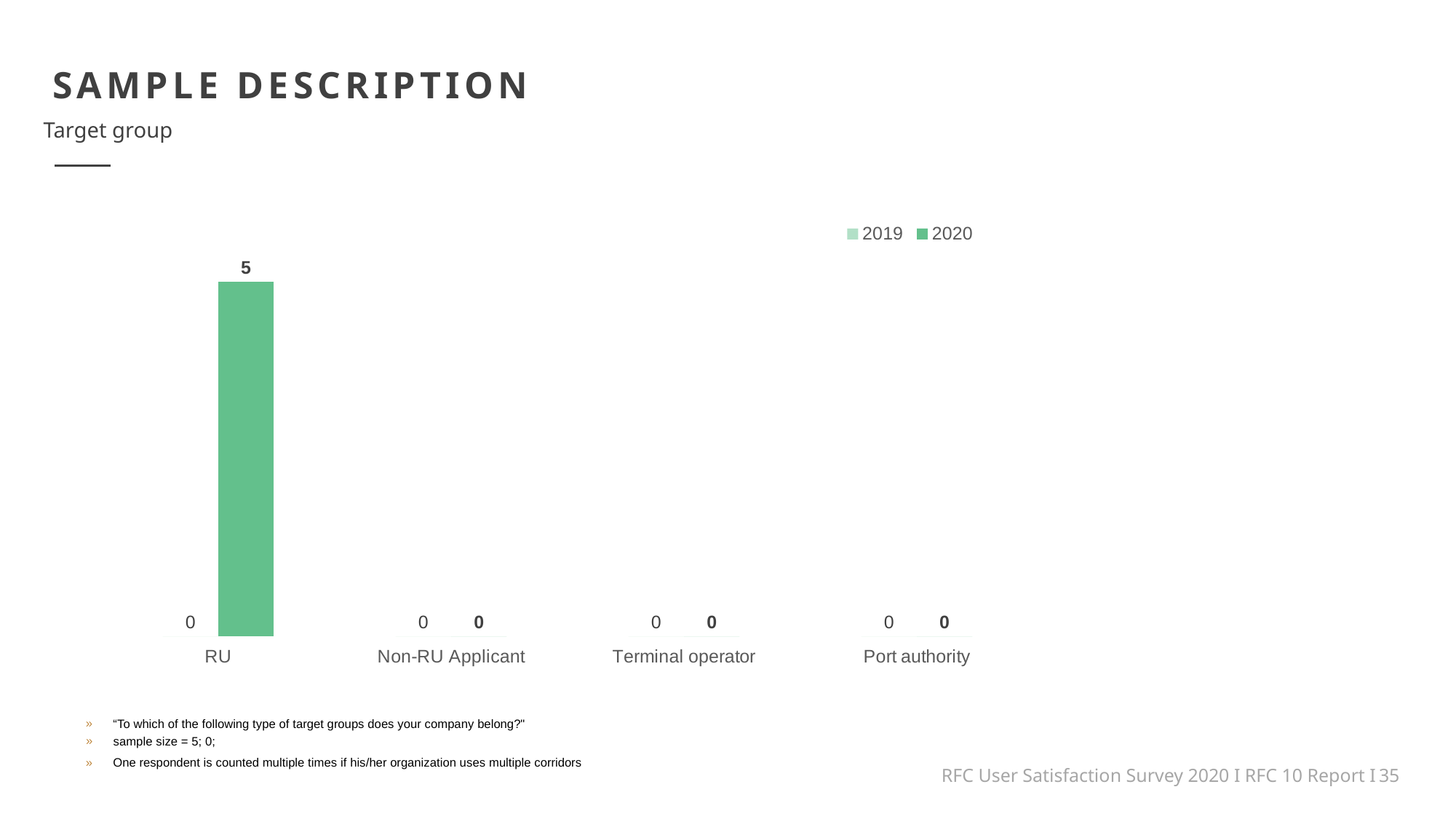
What is the 2020 value for Terminal operator? 0 What kind of chart is shown on the slide? bar chart What is the 2019 value for RU? 0 Which is larger for RU, the 2019 value or the 2020 value? 2020 What is the 2019 value for Port authority? 0 Which category has the highest 2020 value? RU What is the difference between the 2020 and 2019 values for RU? 5 What are the series names listed in the legend? 2019 and 2020 How many categories are shown on the x axis? 4 What is the 2020 value for RU? 5 What is the total of the 2020 values across all four categories? 5 How many series does the legend list? 2